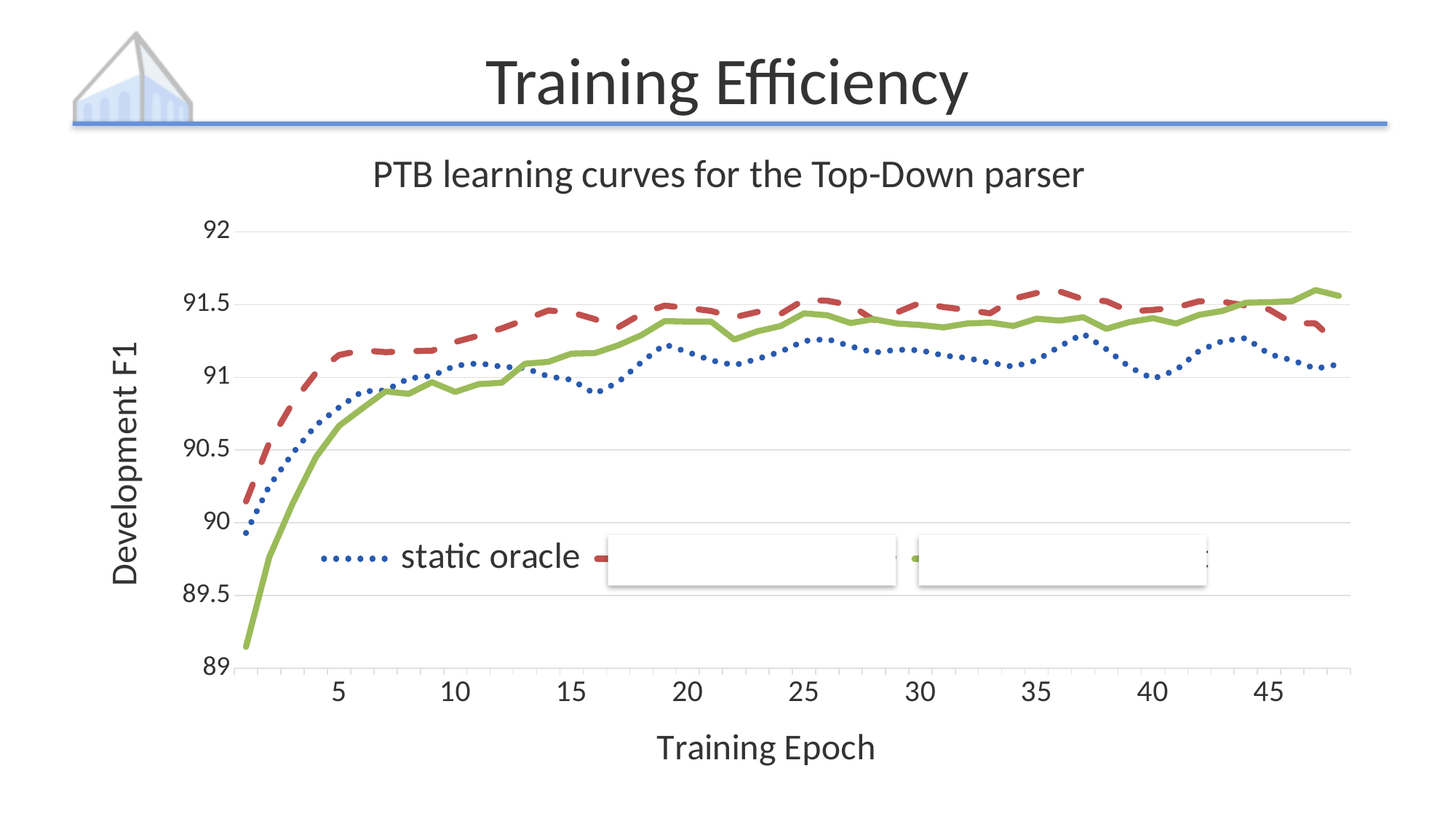
Is the static oracle value at training epoch 5 greater or less than 90.5? greater Is the static oracle value at training epoch 16 greater or less than 91? less Is the static oracle value at training epoch 20 greater or less than 91? greater Does the static oracle line generally rise or fall as the training epoch increases? rise What is the title of the chart? PTB learning curves for the Top-Down parser What kind of chart is shown on the slide? line chart What is the label of the y axis? Development F1 How many lines are plotted on the chart? 3